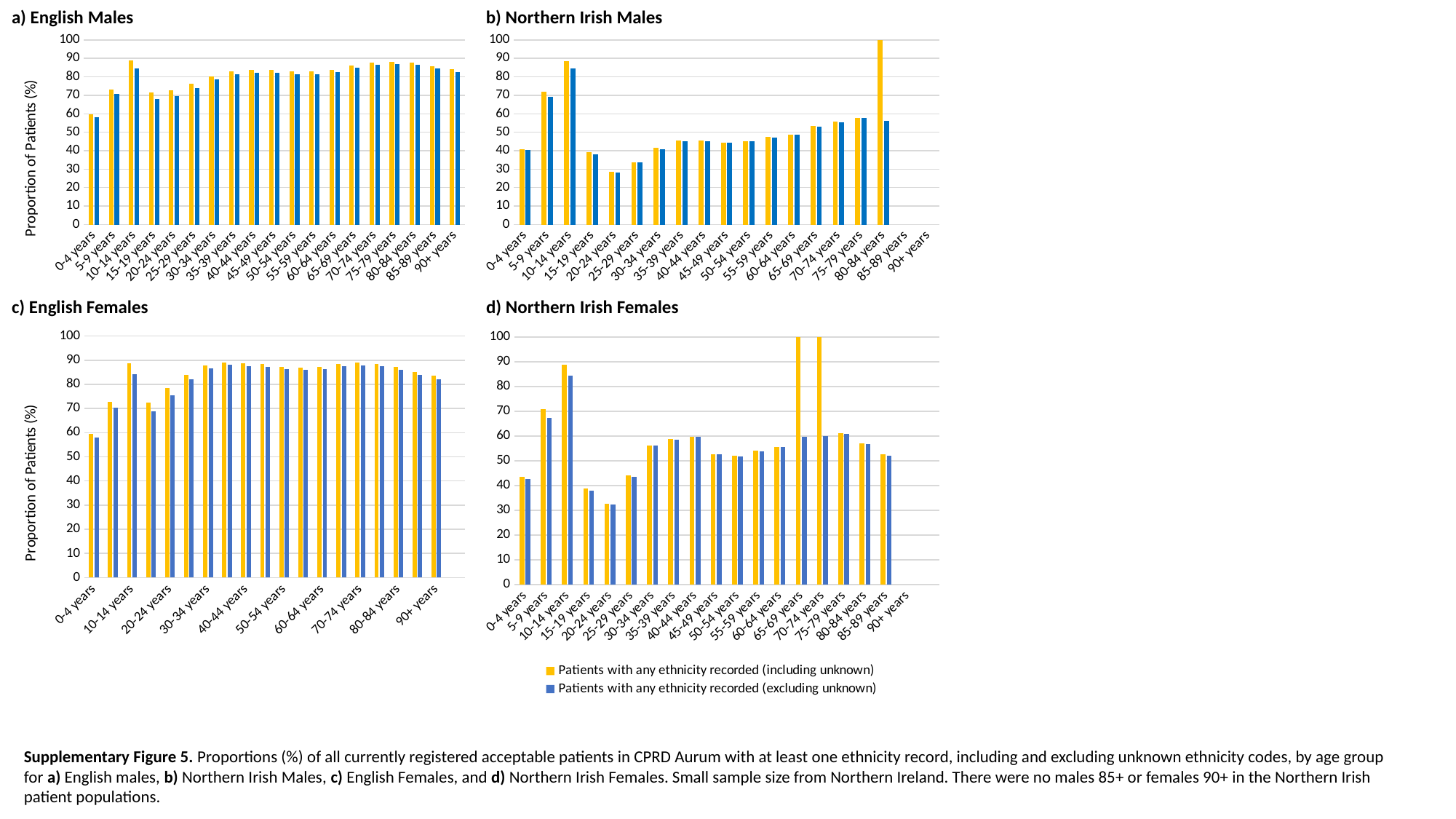
In panel c) English Females, which age group has the lowest proportion of patients? 0-4 years In panel b) Northern Irish Males, which is larger: the value for 10-14 years or the value for 20-24 years? 10-14 years In panel a) English Males, how many age-group categories are shown on the x axis? 19 In panel d) Northern Irish Females, which is larger: the value for 0-4 years or the value for 5-9 years? 5-9 years In panel a) English Males, which age group has the lowest proportion of patients? 0-4 years In panel b) Northern Irish Males, which age group has the lowest proportion of patients? 20-24 years Which colour represents patients with any ethnicity recorded (including unknown)? yellow How many series does the legend list? 2 What type of chart is used in panel a) English Males? bar chart In panel b) Northern Irish Males, which age group has the highest value for patients with any ethnicity recorded (including unknown)? 80-84 years In panel b) Northern Irish Males, is the value for 10-14 years (including unknown) greater or less than 80? greater In panel d) Northern Irish Females, is the value for 20-24 years (including unknown) greater or less than 40? less